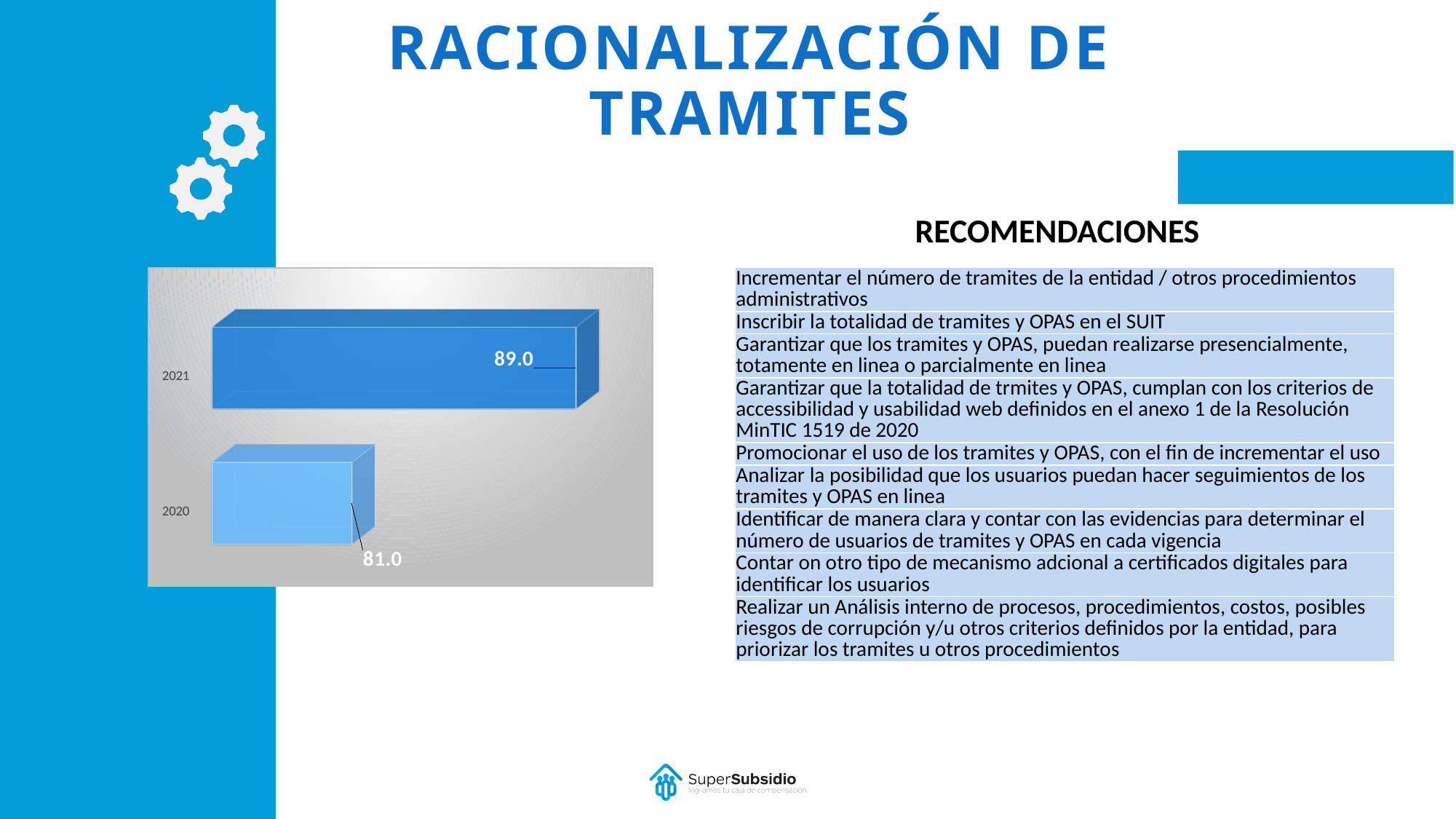
What is the value for 2020? 81.0 How many categories are shown in the chart? 2 Did the value increase or decrease from 2020 to 2021? Increase Which year has the highest value? 2021 Which is larger, the value for 2020 or the value for 2021? 2021 Which category is shown at the top of the chart? 2021 What is the value for 2021? 89.0 What kind of chart is shown on the slide? Bar chart Which year has the lowest value? 2020 What is the difference between the values for 2021 and 2020? 8.0